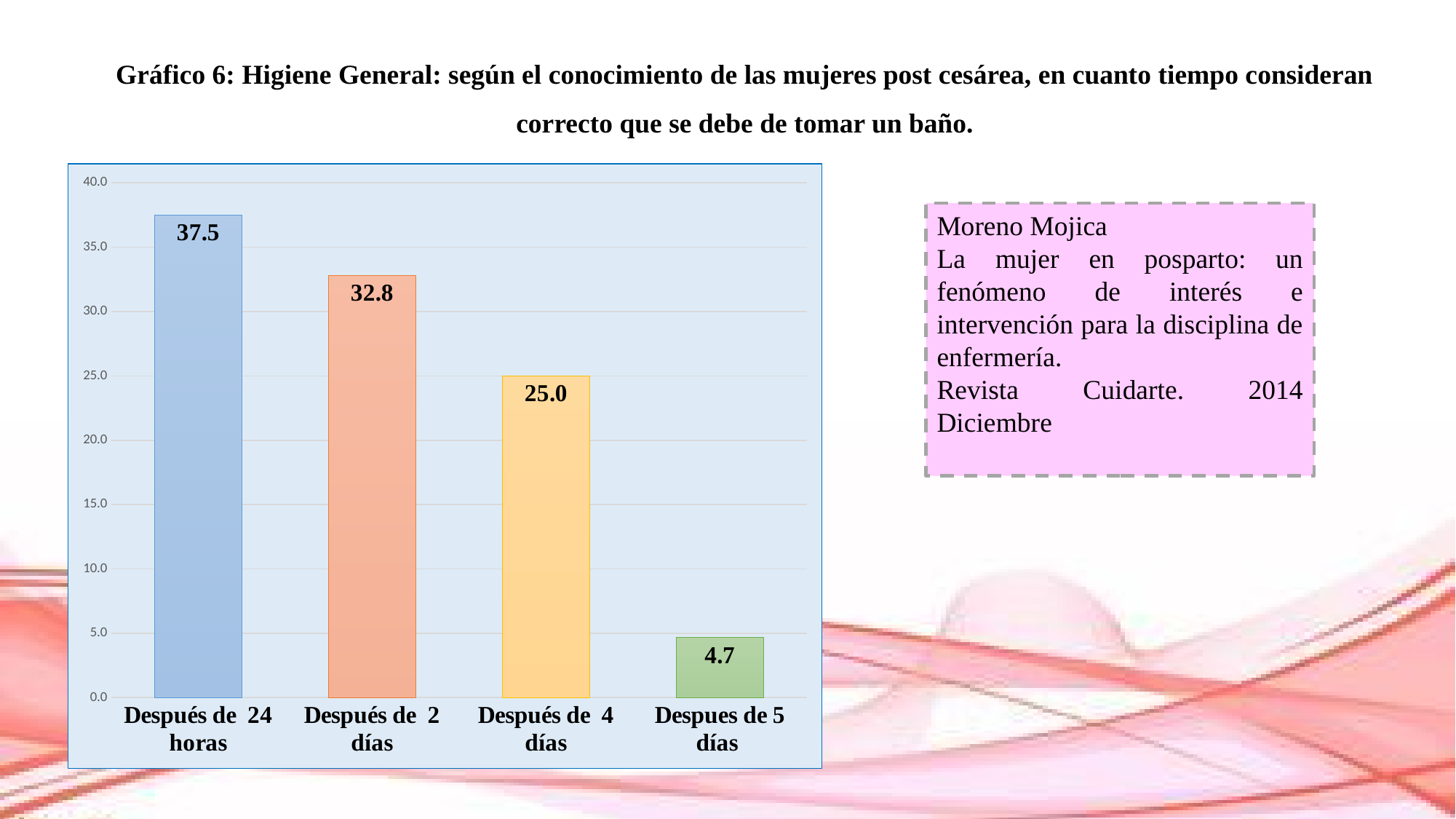
Which category has the highest value? Después de 24 horas What kind of chart is shown on the slide? Bar chart Which is larger, the value for "Después de 2 días" or the value for "Después de 4 días"? Después de 2 días Do the values rise or fall from left to right along the x axis? Fall What is the value for "Despues de 5 días"? 4.7 What is the value for "Después de 24 horas"? 37.5 What is the value for "Después de 4 días"? 25.0 What is the value for "Después de 2 días"? 32.8 What is the difference between the values for "Después de 4 días" and "Despues de 5 días"? 20.3 What is the difference between the values for "Después de 24 horas" and "Después de 2 días"? 4.7 How many categories are shown in the chart? 4 Which category has the lowest value? Despues de 5 días